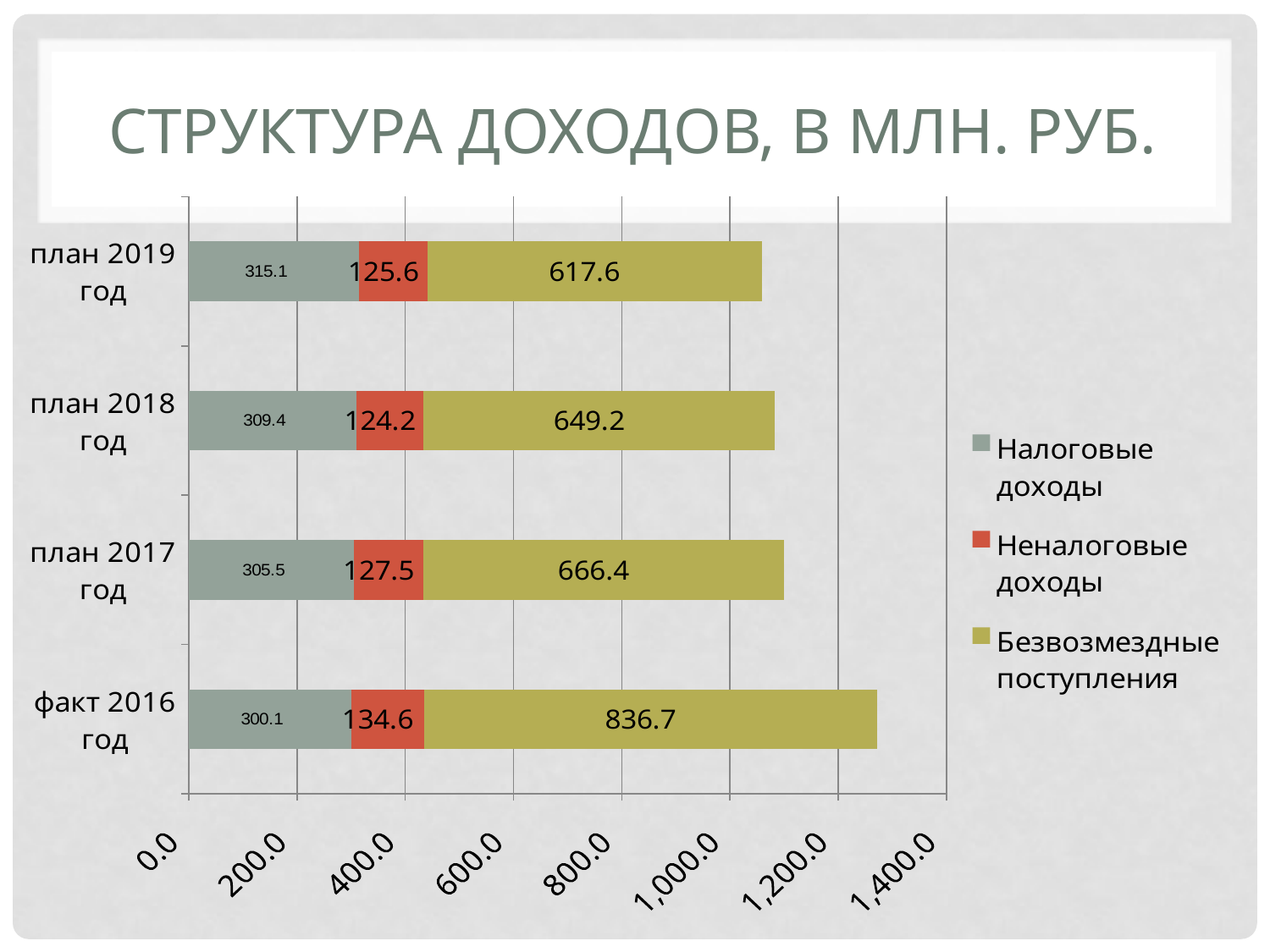
What is the total of the stacked bar for план 2019 год? 1058.3 Which category has the lowest value for Налоговые доходы? факт 2016 год Which category has the highest value for Безвозмездные поступления? факт 2016 год What is the difference between Безвозмездные поступления for план 2017 год and план 2019 год? 48.8 What is the total of the stacked bar for факт 2016 год? 1271.4 What is the value of Неналоговые доходы for план 2017 год? 127.5 How many series does the legend list? 3 How many categories are shown on the chart? 4 Which is larger: Неналоговые доходы for факт 2016 год or for план 2018 год? факт 2016 год What kind of chart is shown on the slide? Stacked bar chart What is the value of Безвозмездные поступления for факт 2016 год? 836.7 What is the value of Налоговые доходы for план 2019 год? 315.1